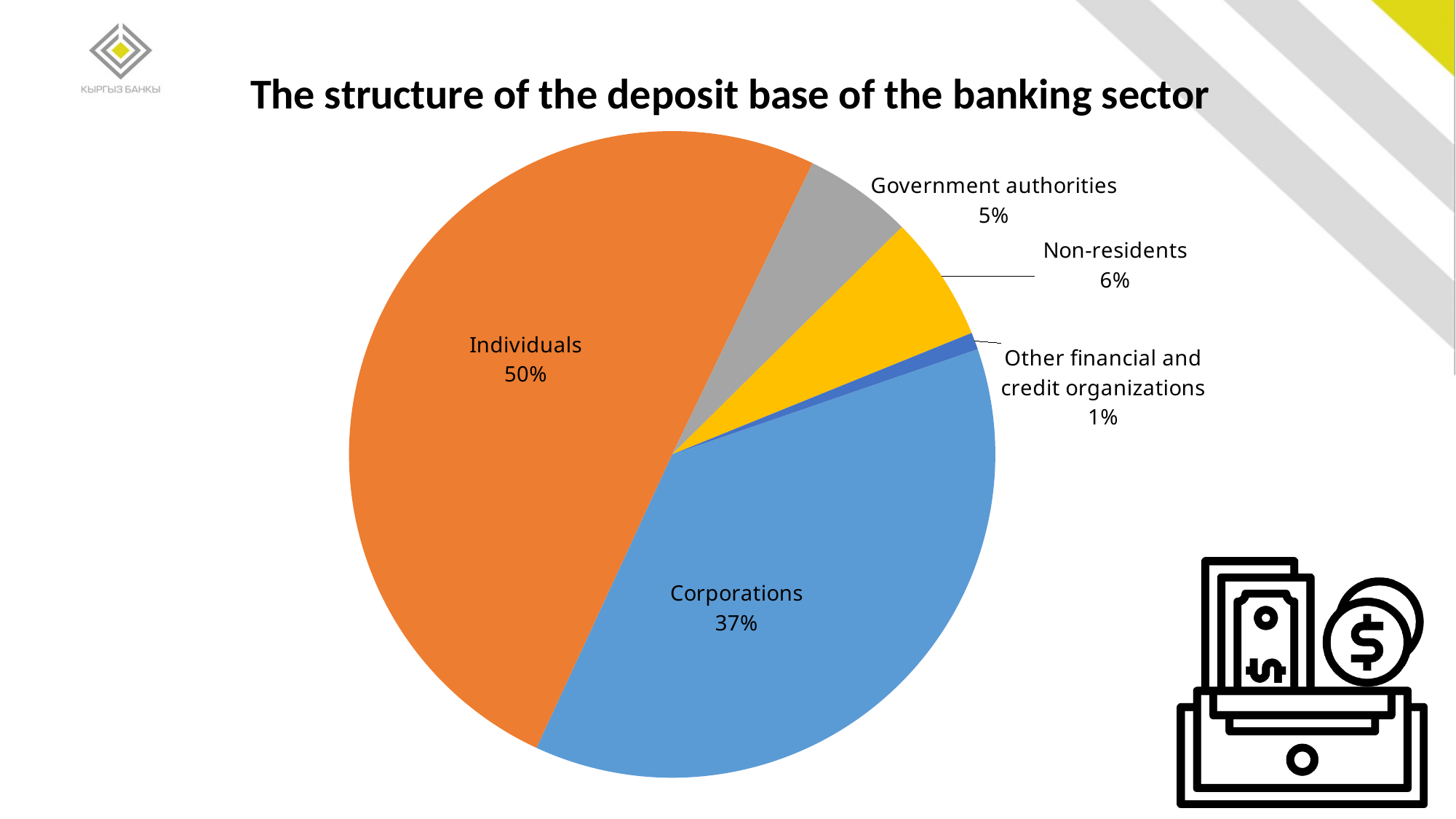
What share of the deposit base do Corporations hold? 37% What share of the deposit base do Other financial and credit organizations hold? 1% What share of the deposit base do Non-residents hold? 6% What share of the deposit base do Individuals hold? 50% Which has a larger share, Non-residents or Government authorities? Non-residents What type of chart is shown on the slide? pie chart What is the title of the chart? The structure of the deposit base of the banking sector Which category has the smallest share of the deposit base? Other financial and credit organizations Which category has the largest share of the deposit base? Individuals How many categories are shown in the pie chart? 5 What is the difference in percentage points between the Individuals and Corporations shares? 13 What share of the deposit base do Government authorities hold? 5%